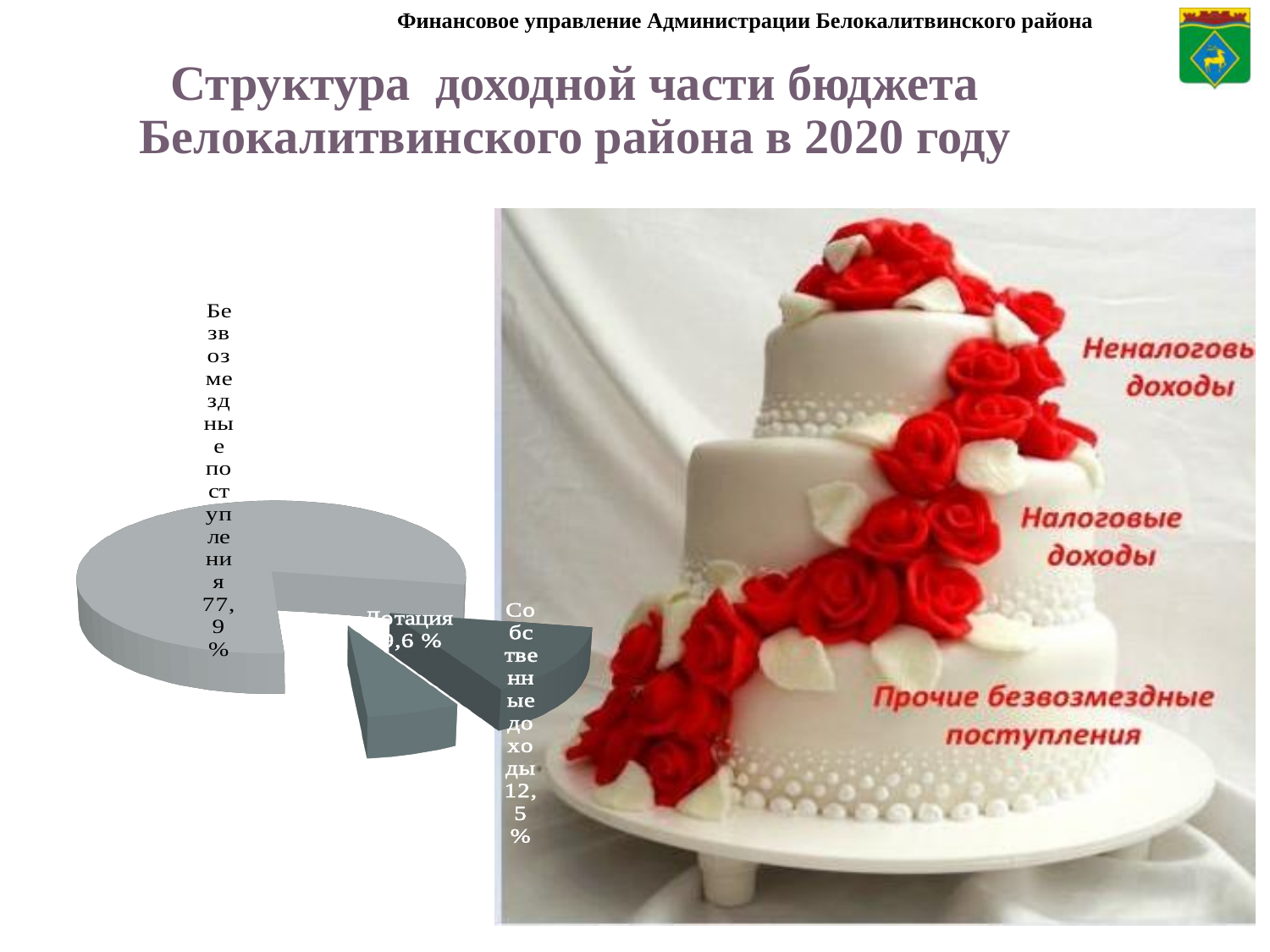
Which slice of the pie chart is the largest? Безвозмездные поступления What kind of chart is shown on the slide? pie chart What is the difference in percentage points between Безвозмездные поступления and Собственные доходы? 65,4 Is the share for Безвозмездные поступления greater or less than 50%? greater What share of the pie chart is labelled "Дотация"? 9,6 % Which slice of the pie chart is the smallest? Дотация Which is larger in the pie chart: Собственные доходы or Дотация? Собственные доходы How many slices does the pie chart have? 3 What share of the pie chart is labelled "Собственные доходы"? 12,5 % What is the title of the slide containing the pie chart? Структура доходной части бюджета Белокалитвинского района в 2020 году What share of the pie chart is labelled "Безвозмездные поступления"? 77,9 %